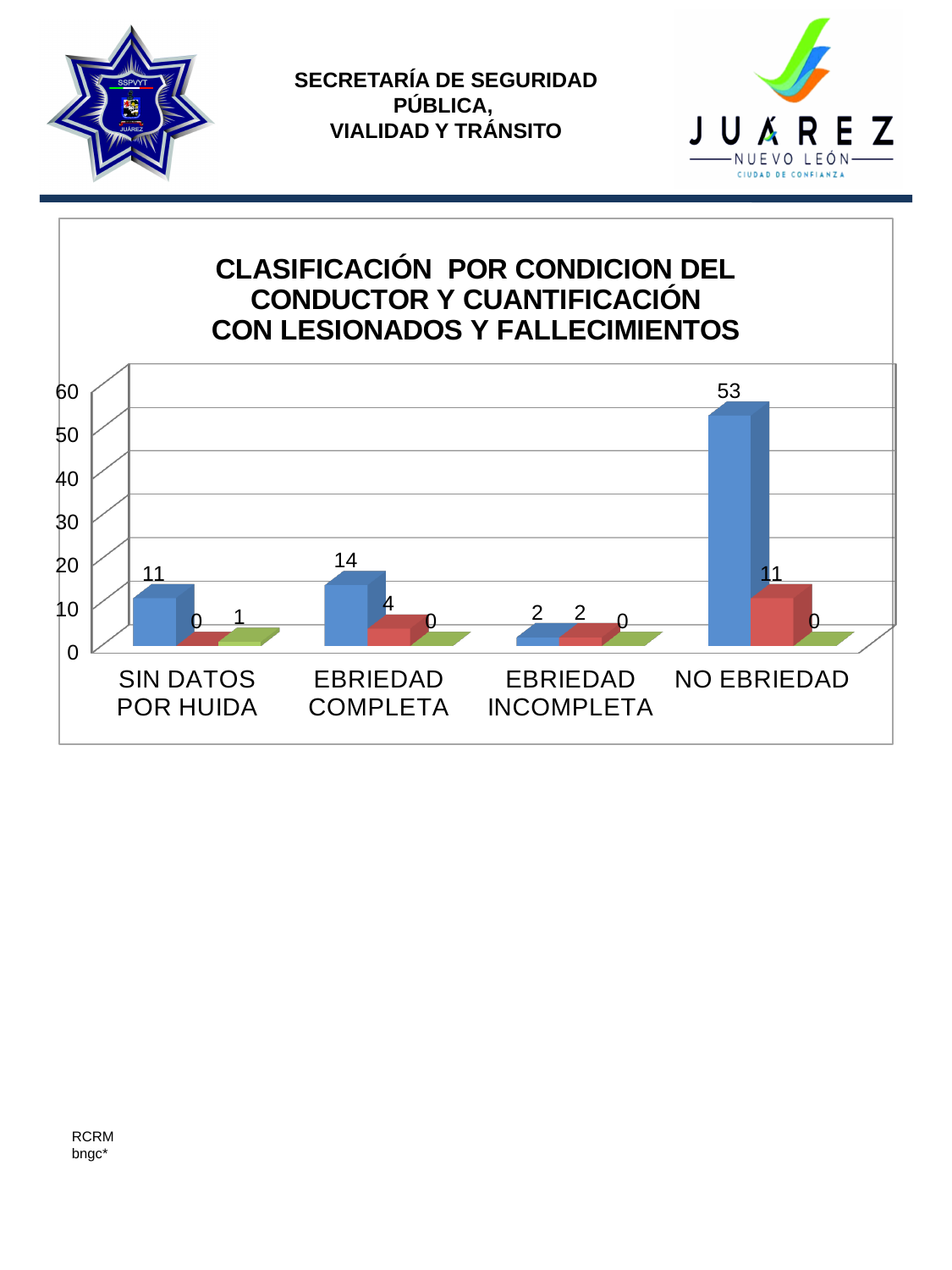
How many bars are plotted for each category? 3 What kind of chart is shown on the slide? bar chart What is the difference between the blue bar for NO EBRIEDAD and the blue bar for EBRIEDAD COMPLETA? 39 What is the value of the green bar for SIN DATOS POR HUIDA? 1 Which category has the lowest blue bar? EBRIEDAD INCOMPLETA What is the value of the blue bar for NO EBRIEDAD? 53 How many categories are shown on the x axis? 4 What is the value of the red bar for EBRIEDAD COMPLETA? 4 Which is larger: the blue bar for SIN DATOS POR HUIDA or the blue bar for EBRIEDAD COMPLETA? EBRIEDAD COMPLETA What is the value of the blue bar for EBRIEDAD INCOMPLETA? 2 What is the title of the chart? CLASIFICACIÓN POR CONDICION DEL CONDUCTOR Y CUANTIFICACIÓN CON LESIONADOS Y FALLECIMIENTOS Which category has the highest blue bar? NO EBRIEDAD